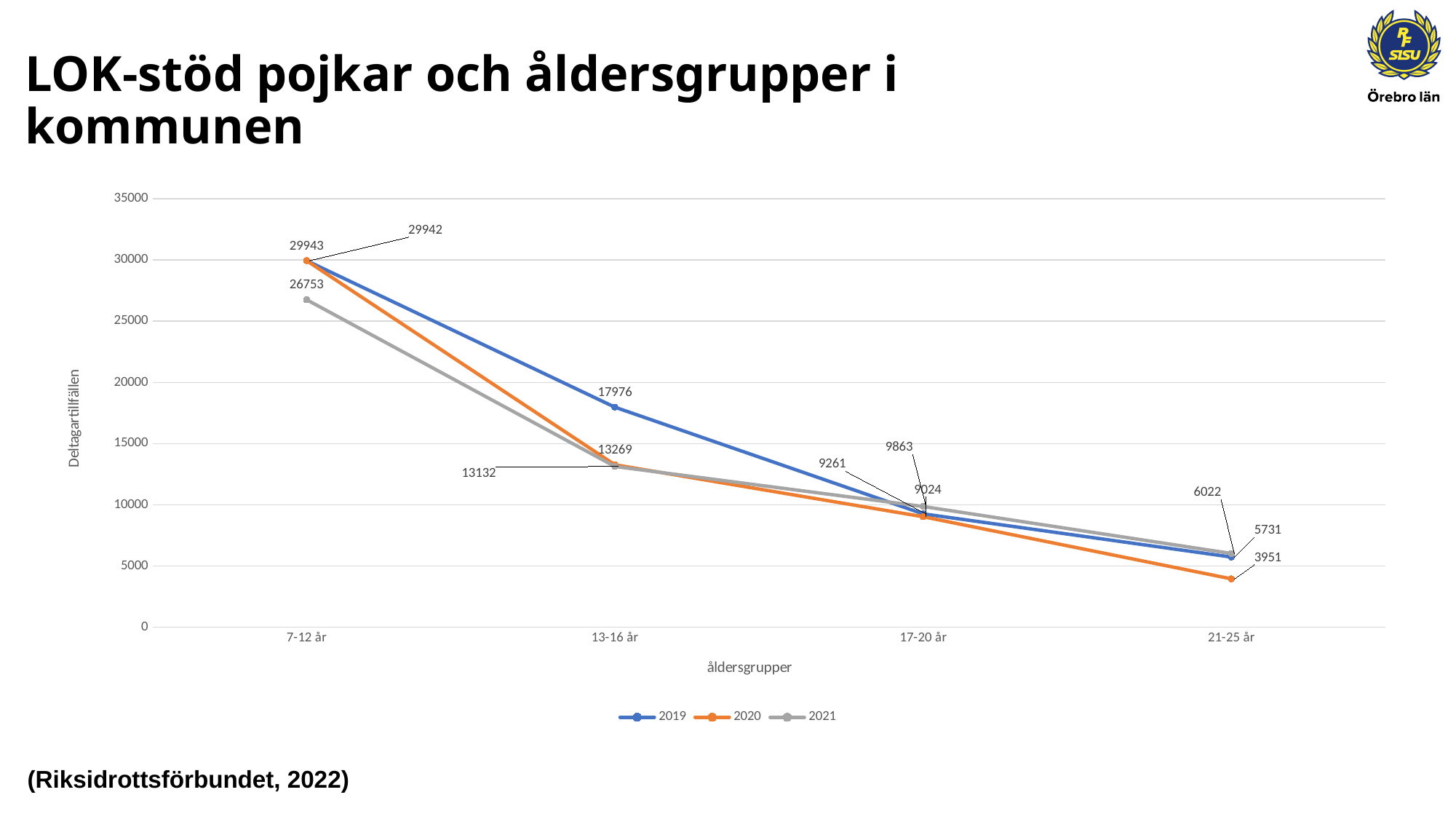
How many age groups are shown on the x axis? 4 Which age group has the highest value for the 2019 series? 7-12 år What kind of chart is shown on the slide? line chart How many series does the legend list? 3 Do the values for the 2020 series rise or fall from 7-12 år to 21-25 år? fall What is the value for 2020 in the 21-25 år age group? 3951 What is the value for 2019 in the 13-16 år age group? 17976 What is the difference between the 2021 and 2020 values in the 21-25 år age group? 2071 In the 21-25 år age group, which is larger: the value for 2019 or for 2020? 2019 What is the value for 2021 in the 21-25 år age group? 6022 Which age group has the lowest value for the 2020 series? 21-25 år What is the value for 2021 in the 7-12 år age group? 26753